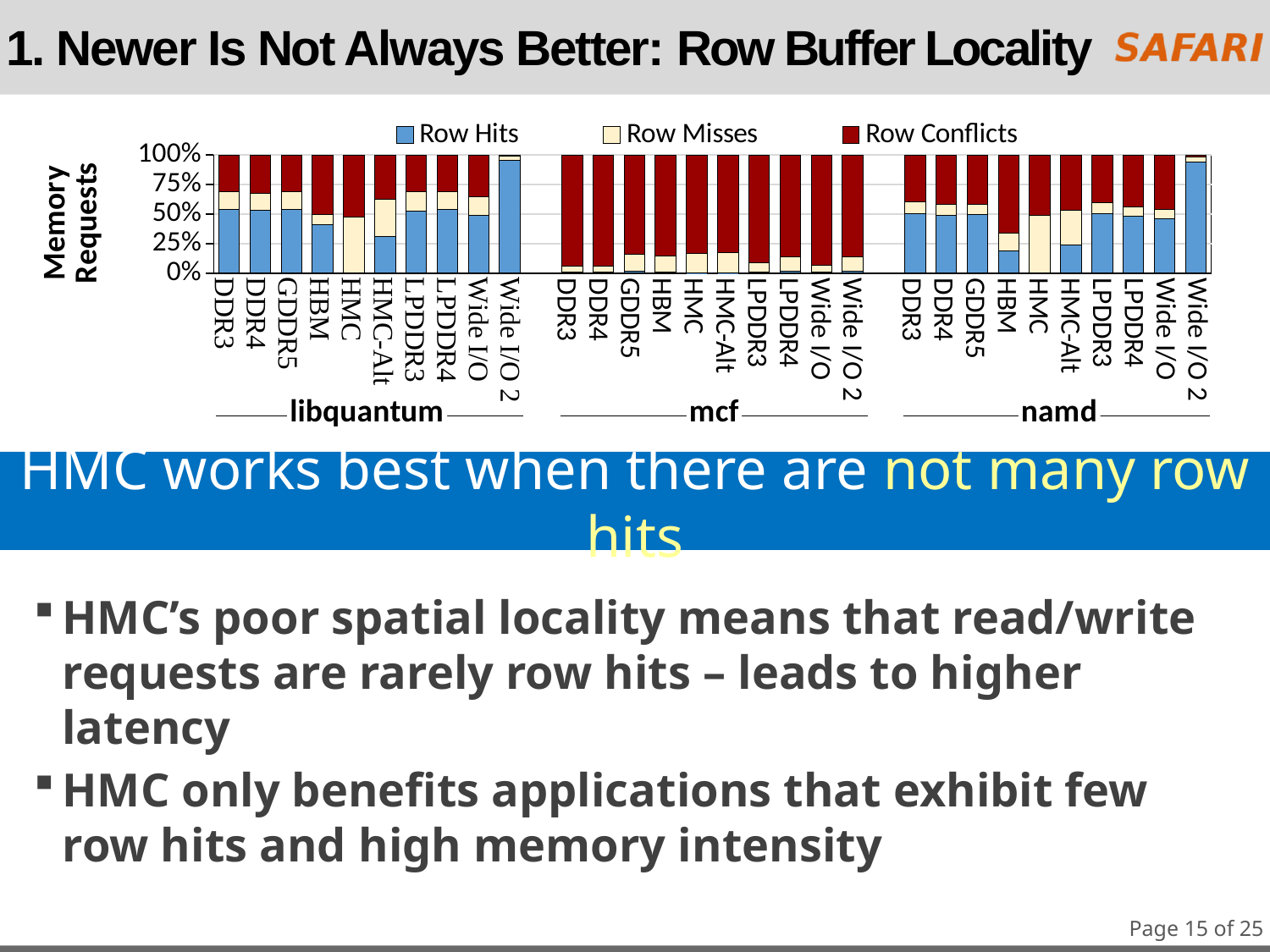
How many workload groups are shown along the x axis of the chart? 3 In the mcf group, is the Row Hits share for DDR3 greater or less than 25%? less How many series does the chart legend list? 3 What are the three series listed in the chart legend? Row Hits, Row Misses, Row Conflicts In the libquantum group, is the Row Hits share for Wide I/O 2 greater or less than 75%? greater In the libquantum group, which has the larger Row Hits share: HBM or HMC-Alt? HBM What kind of chart is shown on the slide? stacked bar chart How many memory types are plotted within each workload group (e.g., libquantum)? 10 In the namd group, which memory type has the highest share of Row Hits? Wide I/O 2 In the libquantum group, which memory type has the highest share of Row Hits? Wide I/O 2 What is the label on the y axis of the chart? Memory Requests In the namd group, is the Row Hits share for HBM greater or less than 25%? less